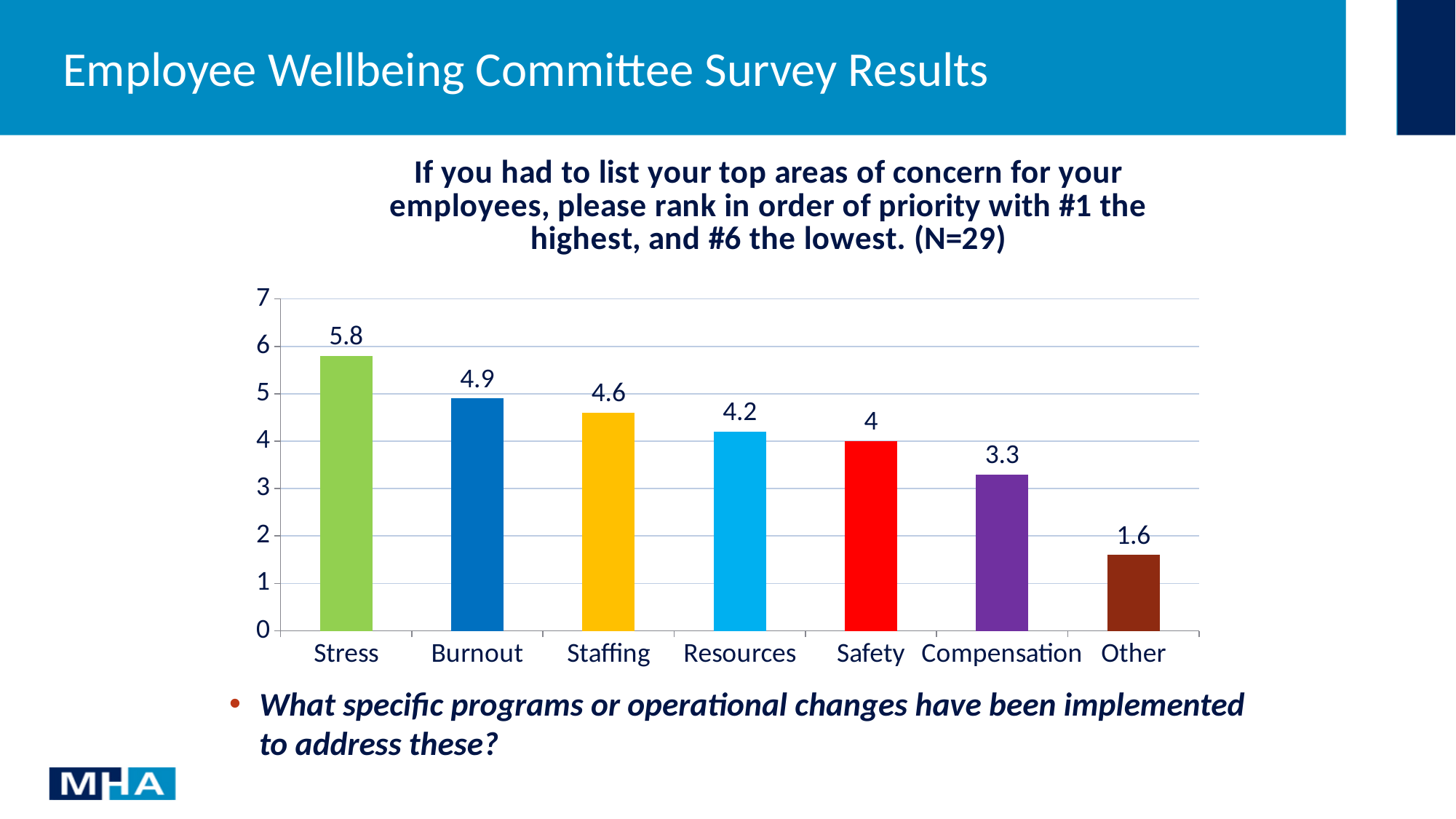
What is the value for Stress? 5.8 Which category has the highest value? Stress What is the value for Compensation? 3.3 Which category has the lowest value? Other What is the value for Safety? 4 How many categories are shown on the x axis? 7 What is the difference between the values for Resources and Other? 2.6 What is the difference between the values for Stress and Burnout? 0.9 Do the values rise or fall from left to right along the x axis? Fall What kind of chart is shown on the slide? Bar chart Which is larger, the value for Staffing or the value for Compensation? Staffing Is the value for Burnout greater or less than 4? greater